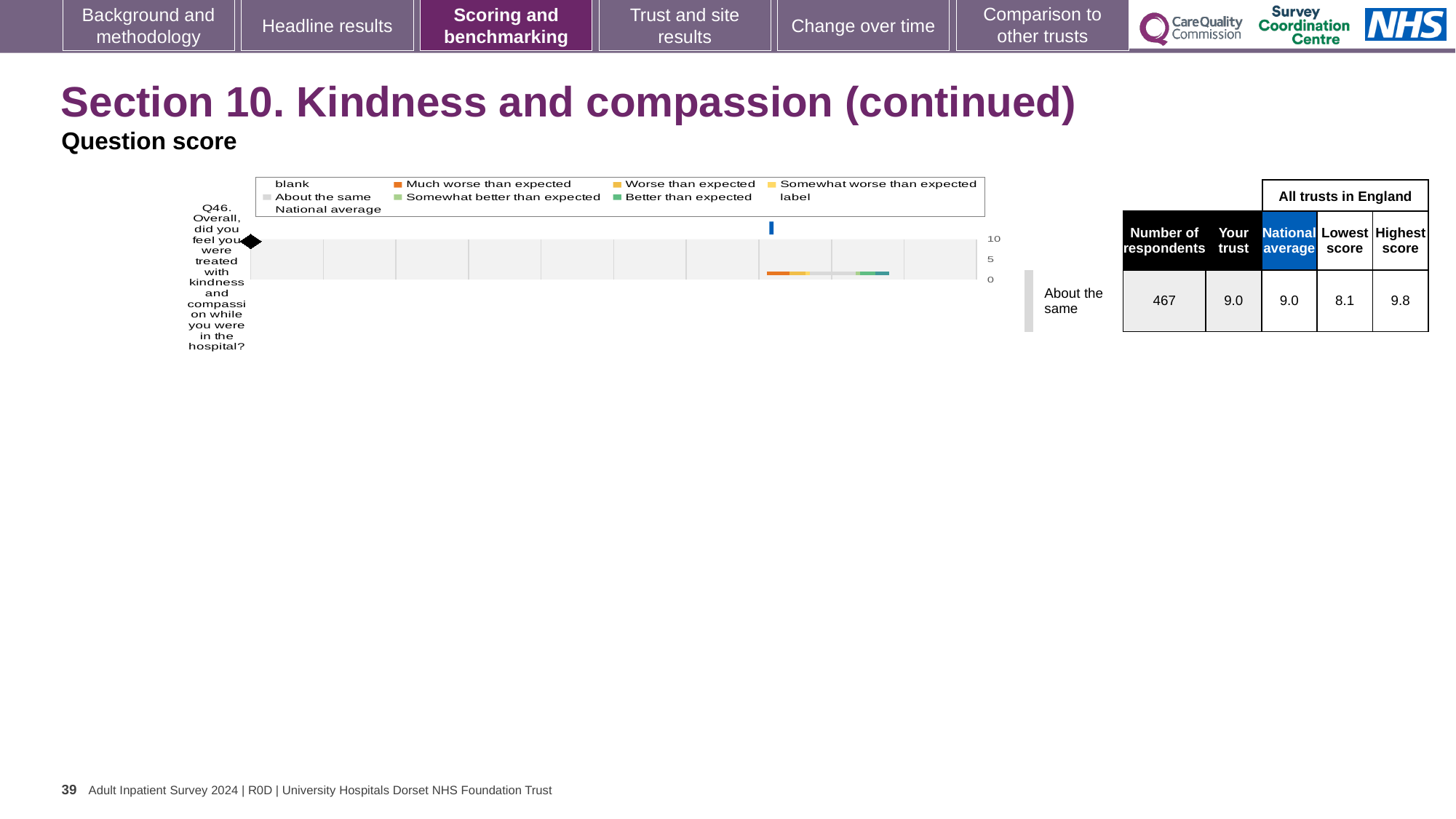
How many entries does the chart legend list? 9 What is the lowest score among all trusts in England for Q46? 8.1 What benchmarking category is the trust's Q46 score placed in? About the same What is the 'Your trust' score for Q46 in the table beside the chart? 9.0 What is the highest score among all trusts in England for Q46? 9.8 Which question number is plotted in the chart? Q46 What kind of chart is shown on the slide? bar chart How many respondents answered Q46? 467 What is the difference between the highest score and the lowest score for Q46? 1.7 What is the national average score for Q46 in the table beside the chart? 9.0 How many survey questions are plotted in the chart? 1 What is the highest tick value shown on the chart's value axis? 10